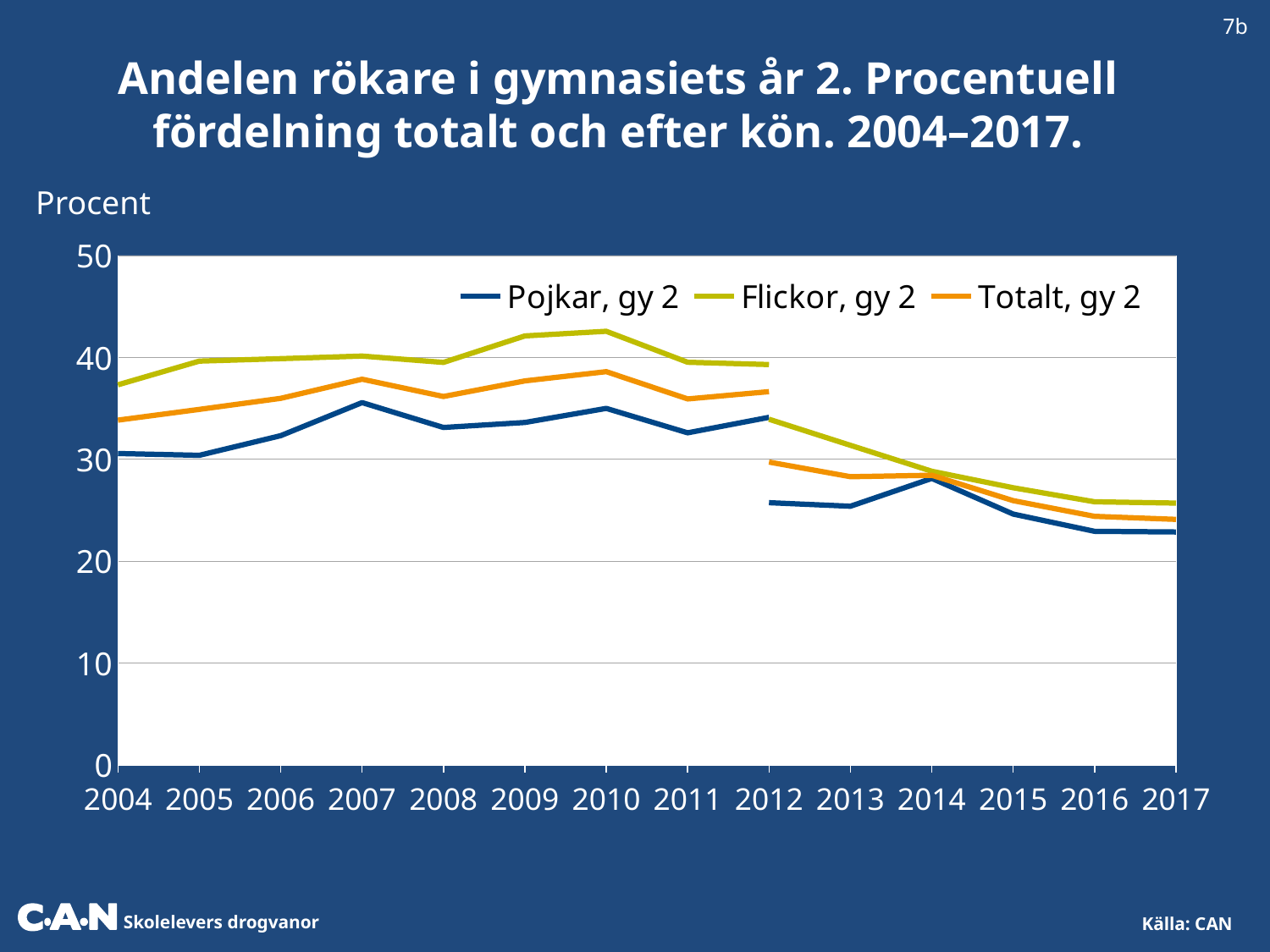
Is the value for Flickor, gy 2 in 2010 greater or less than 40? greater What label is shown on the vertical axis of the chart? Procent Do the values for Flickor, gy 2 rise or fall from 2012 to 2017? fall Is the value for Flickor, gy 2 in 2004 greater or less than 40? less For Pojkar, gy 2, which year has the higher value, 2013 or 2014? 2014 Is the value for Totalt, gy 2 in 2013 greater or less than 30? less Which series has the higher value in 2010, Flickor, gy 2 or Pojkar, gy 2? Flickor, gy 2 What kind of chart is shown on the slide? line chart How many years are shown on the x axis? 14 How many series does the legend list? 3